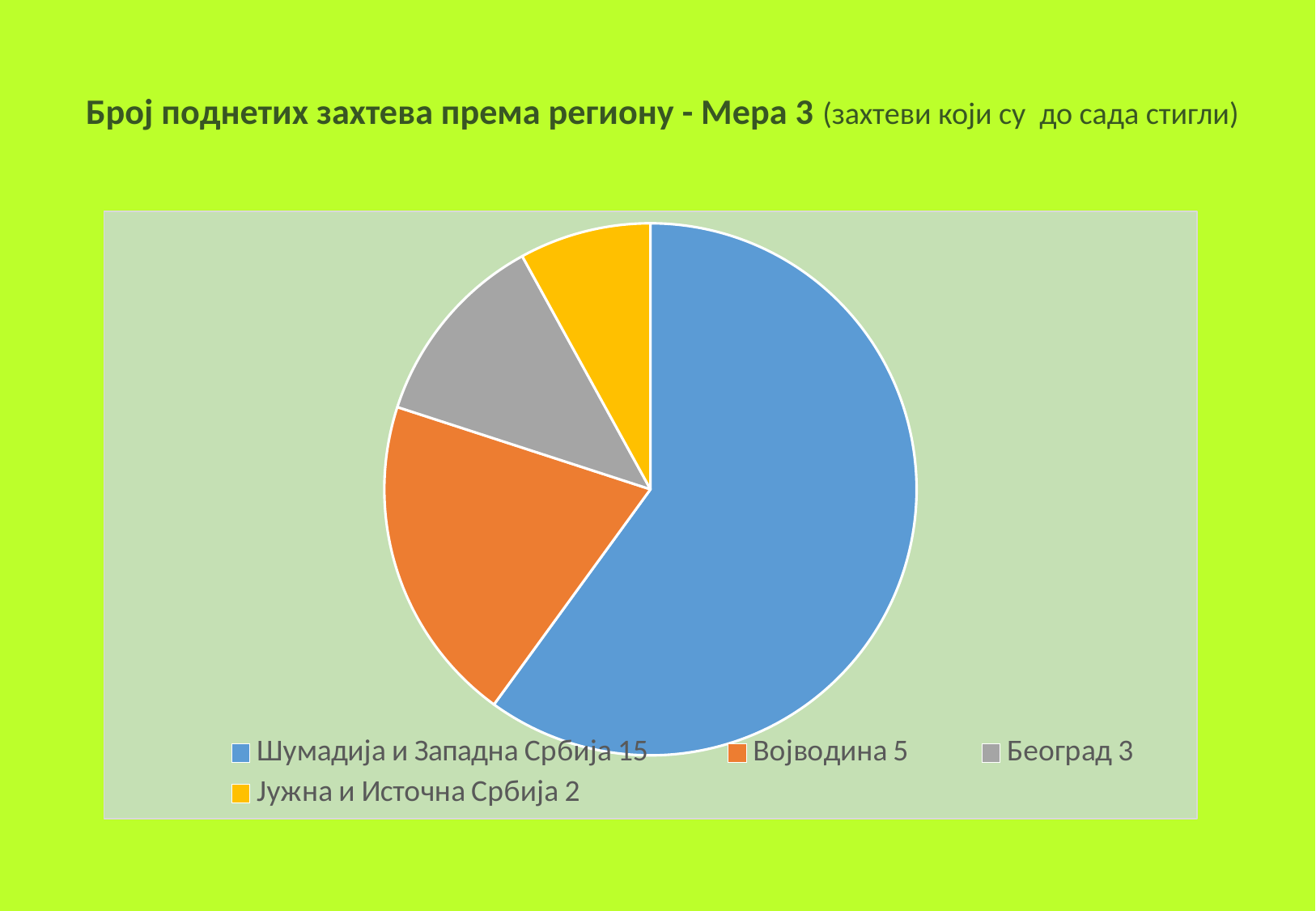
Which region has the smallest slice of the pie? Јужна и Источна Србија Which is larger, the value for Београд or the value for Јужна и Источна Србија? Београд How many slices does the pie chart have? 4 What is the difference between the values for Шумадија и Западна Србија and Војводина? 10 Which region has the largest slice of the pie? Шумадија и Западна Србија What is the value for Шумадија и Западна Србија? 15 What is the value for Београд? 3 What type of chart is shown on the slide? pie chart What colour is the slice for Војводина? orange What is the value for Јужна и Источна Србија? 2 What is the value for Војводина? 5 What share of the pie does Шумадија и Западна Србија represent? 60%